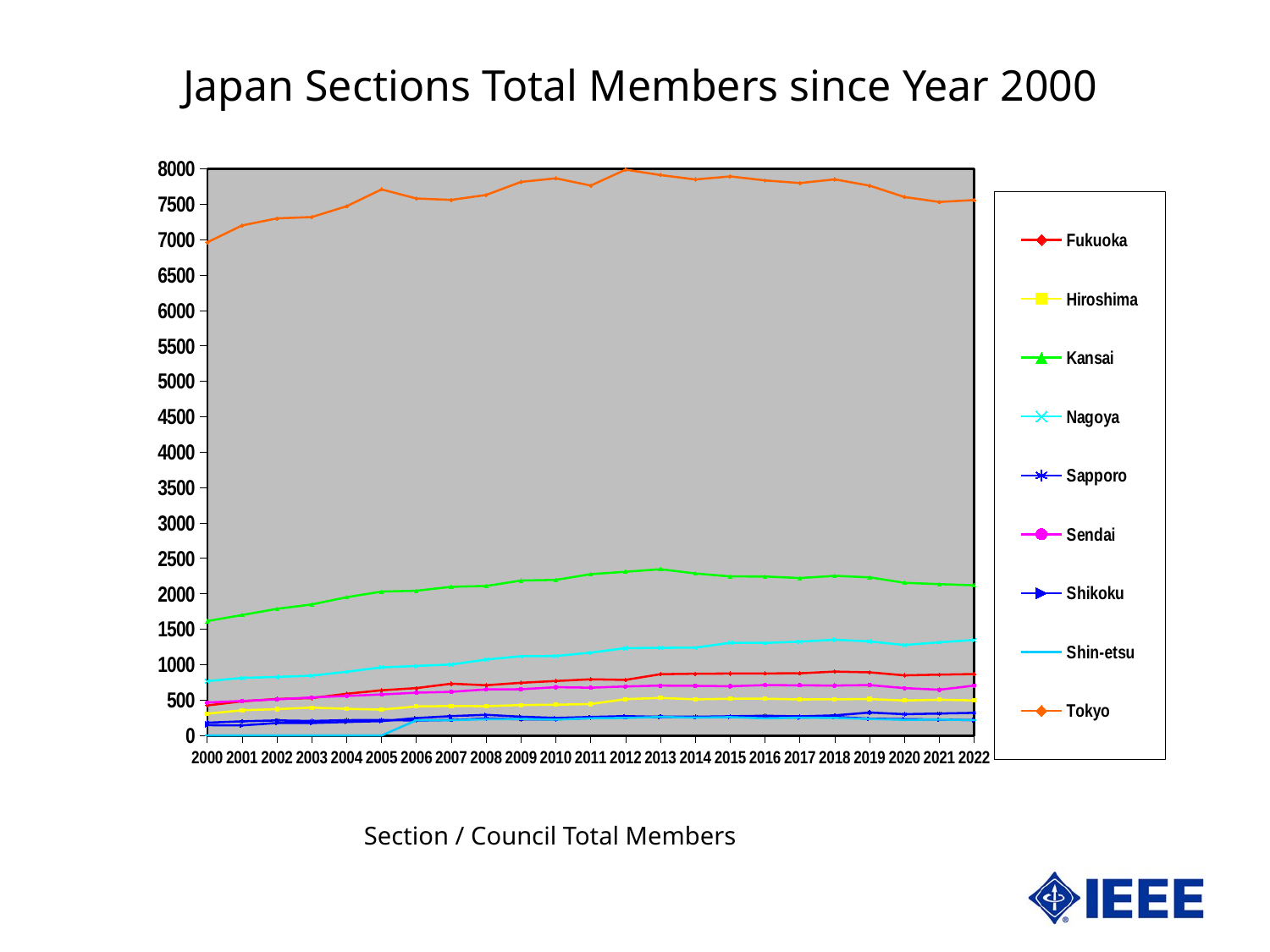
How many years are plotted along the x axis? 23 Which section has the highest total members across the whole period? Tokyo What kind of chart is shown on the slide? Line chart Is the value for Kansai in 2000 greater or less than 1500? greater Is the value for Kansai in 2022 greater or less than 2500? less Is the value for Tokyo in 2000 greater or less than 6500? greater Which is larger in 2022, Kansai or Nagoya? Kansai What is the title of the chart? Japan Sections Total Members since Year 2000 How many series does the legend list? 9 Does the Tokyo line rise or fall from 2000 to 2012? Rise Which section has the second-highest line on the chart? Kansai